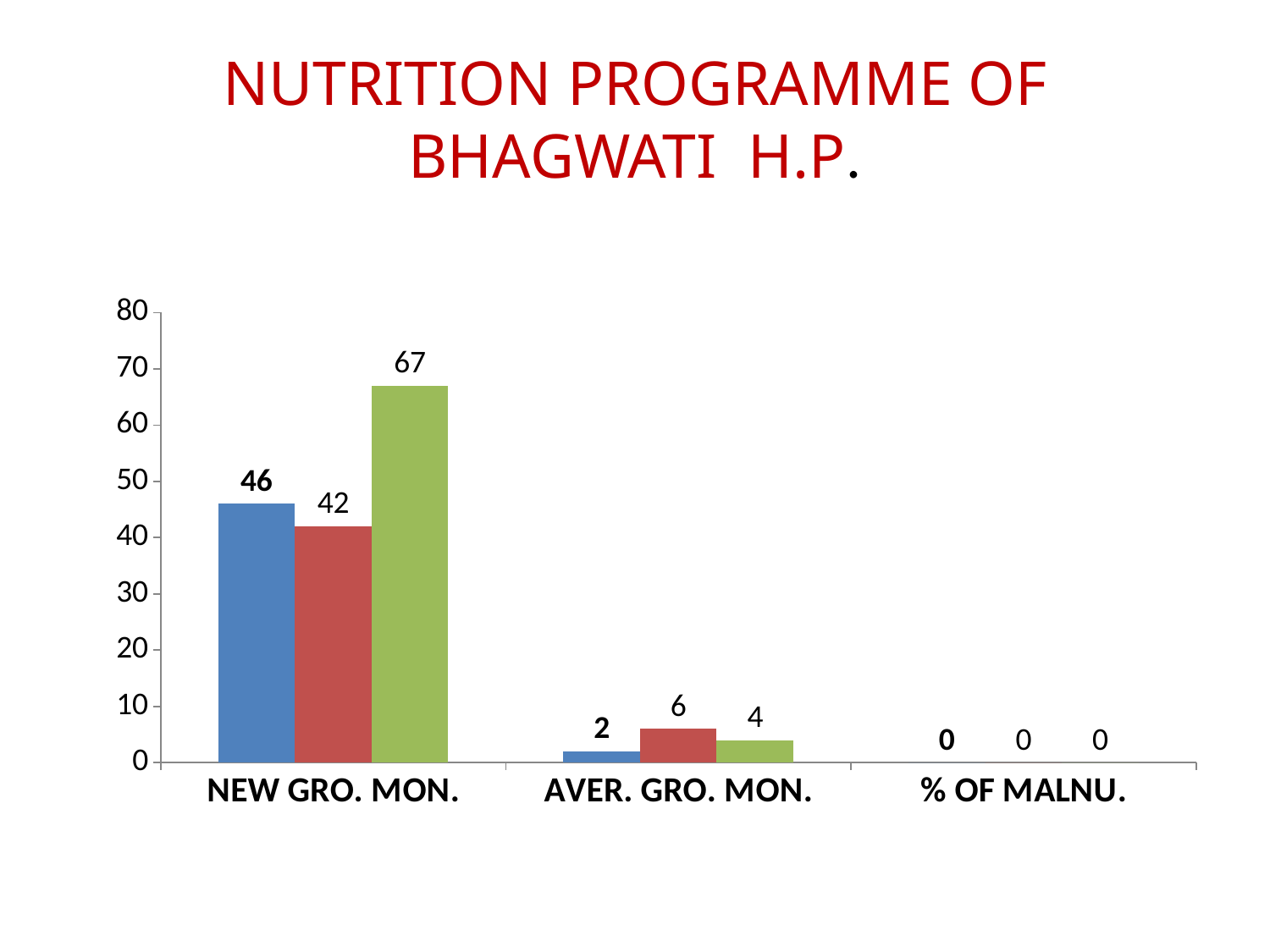
What is the difference between the blue bar and the red bar for NEW GRO. MON.? 4 What kind of chart is shown on the slide? bar chart What is the title of the slide? NUTRITION PROGRAMME OF BHAGWATI H.P. What is the value of the red bar for AVER. GRO. MON.? 6 Which category has the lowest values on the chart? % OF MALNU. Which is larger for AVER. GRO. MON., the blue bar or the red bar? the red bar What is the difference between the green bar and the red bar for NEW GRO. MON.? 25 How many categories are shown on the x axis? 3 Which category has the highest bar on the chart? NEW GRO. MON. What is the value of the green bar for NEW GRO. MON.? 67 What is the value of the green bar for AVER. GRO. MON.? 4 What is the value of the blue bar for NEW GRO. MON.? 46